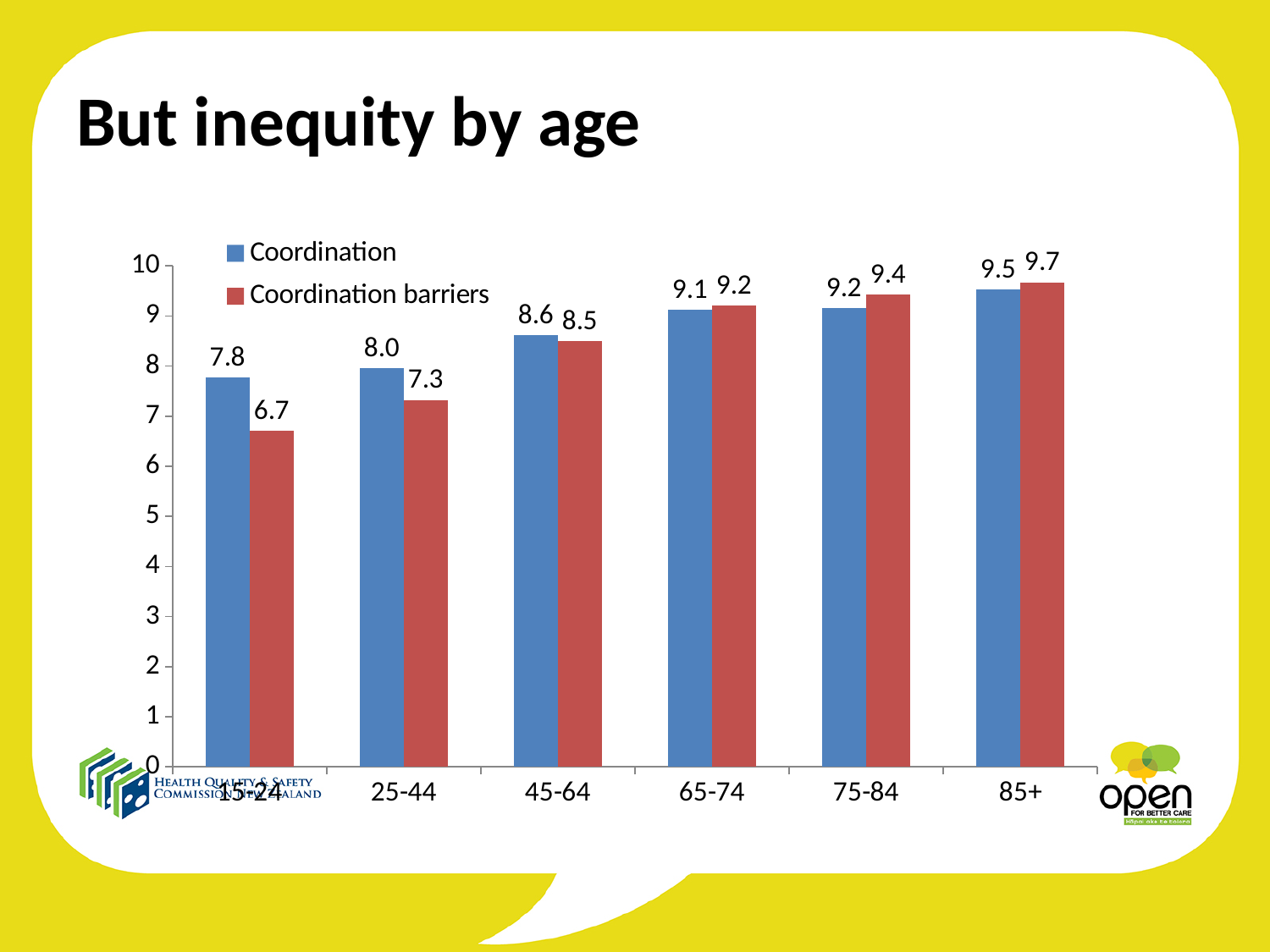
How many age groups are shown on the x axis? 6 For the 85+ age group, what is the difference between the Coordination barriers value and the Coordination value? 0.2 Which age group has the highest Coordination barriers value? 85+ What is the Coordination barriers value for the 75-84 age group? 9.4 For the 15-24 age group, how much higher is the Coordination value than the Coordination barriers value? 1.1 Which age group has the lowest Coordination value? 15-24 What is the Coordination value for the 25-44 age group? 8.0 Do the Coordination values rise or fall as the age groups get older along the x axis? Rise What kind of chart is shown on the slide? Bar chart What is the Coordination barriers value for the 65-74 age group? 9.2 How many series does the legend list? 2 For the 45-64 age group, which series has the larger value, Coordination or Coordination barriers? Coordination